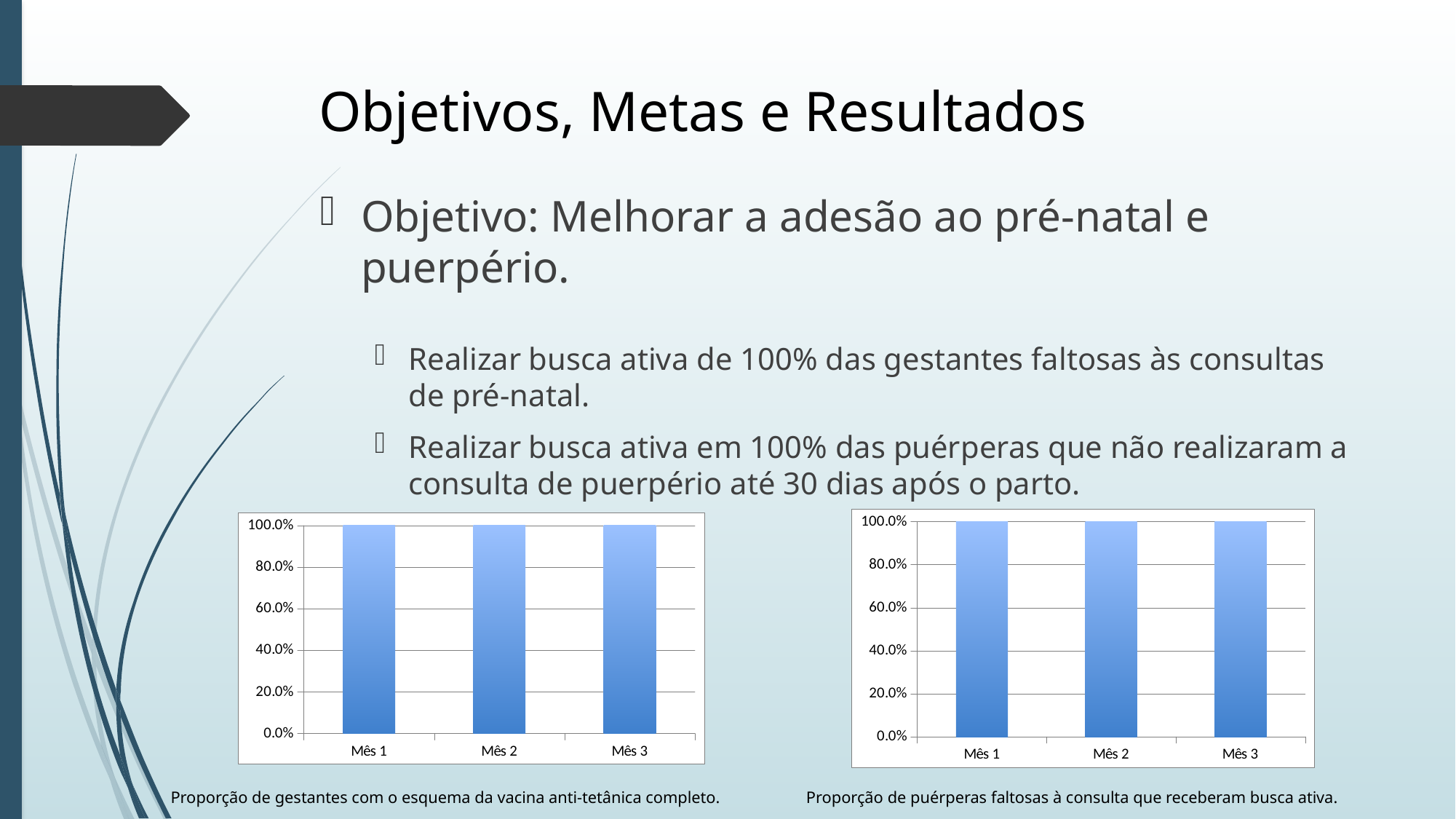
What is the caption below the right chart? Proporção de puérperas faltosas à consulta que receberam busca ativa. In the right chart, is the value for Mês 1 greater or less than 60.0%? greater In the right chart (Proporção de puérperas faltosas à consulta que receberam busca ativa), what is the value for Mês 3? 100.0% In the left chart, is the value for Mês 3 greater or less than 80.0%? greater How many bars does the right chart have? 3 In the left chart, do the values rise, fall, or stay the same from Mês 1 to Mês 3? Stay the same How many categories are shown on the x axis of the left chart? 3 What kind of chart is the right chart? Bar chart In the right chart, what is the value for Mês 2? 100.0% In the left chart (Proporção de gestantes com o esquema da vacina anti-tetânica completo), what is the value for Mês 1? 100.0% In the left chart, what is the value for Mês 2? 100.0% What kind of chart is the left chart? Bar chart